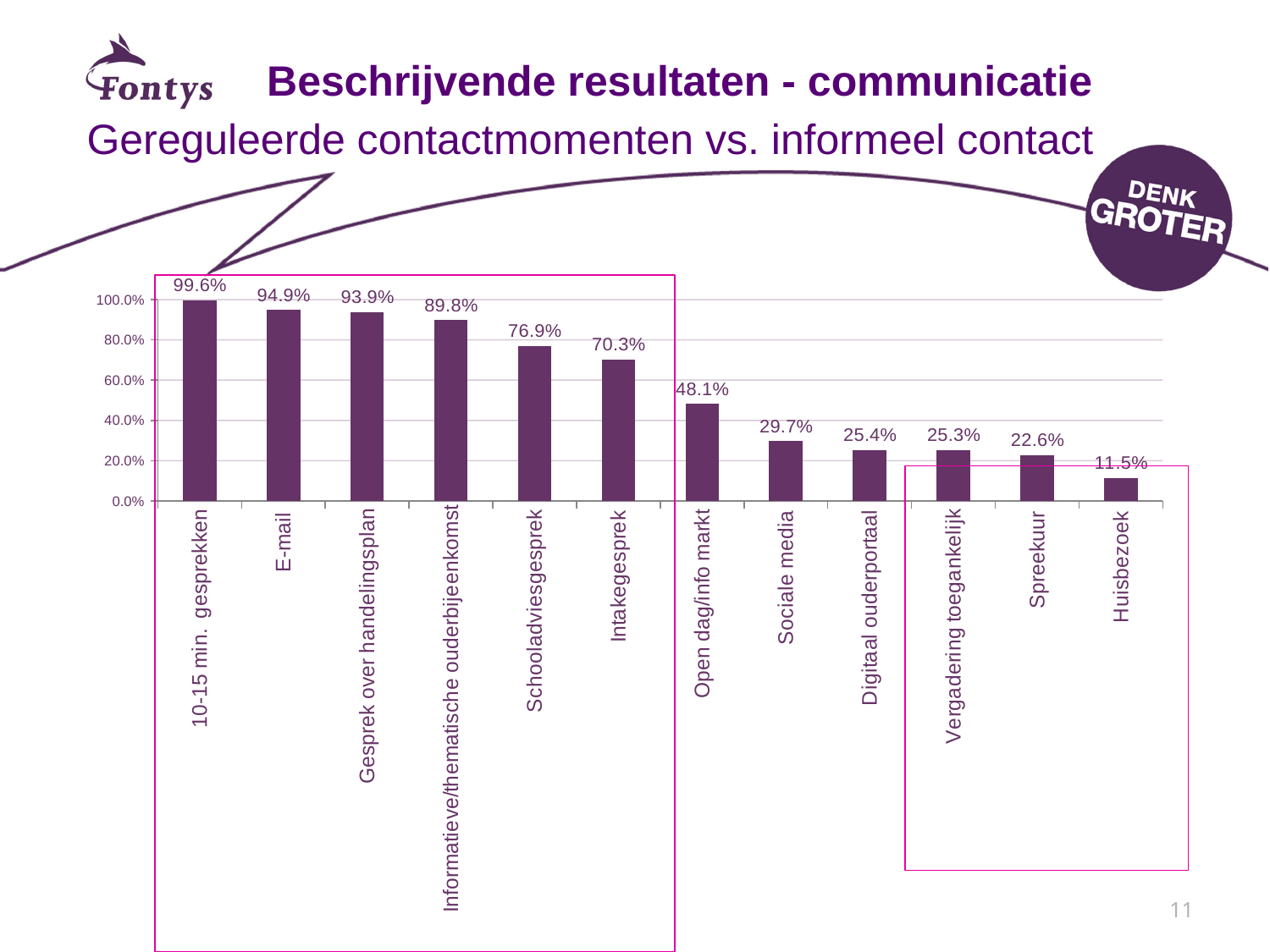
What kind of chart is shown on the slide? Bar chart Which is larger, the value for Sociale media or the value for Spreekuur? Sociale media Is the value for Informatieve/thematische ouderbijeenkomst greater or less than 80.0%? greater What value is shown for Open dag/info markt? 48.1% Do the values rise or fall from left to right along the x axis? Fall Which category has the highest value? 10-15 min. gesprekken What value is shown for E-mail? 94.9% What value is shown for Huisbezoek? 11.5% What is the difference between the values for Intakegesprek and Open dag/info markt? 22.2% What value is shown for Schooladviesgesprek? 76.9% Which category has the lowest value? Huisbezoek How many categories are shown in the chart? 12